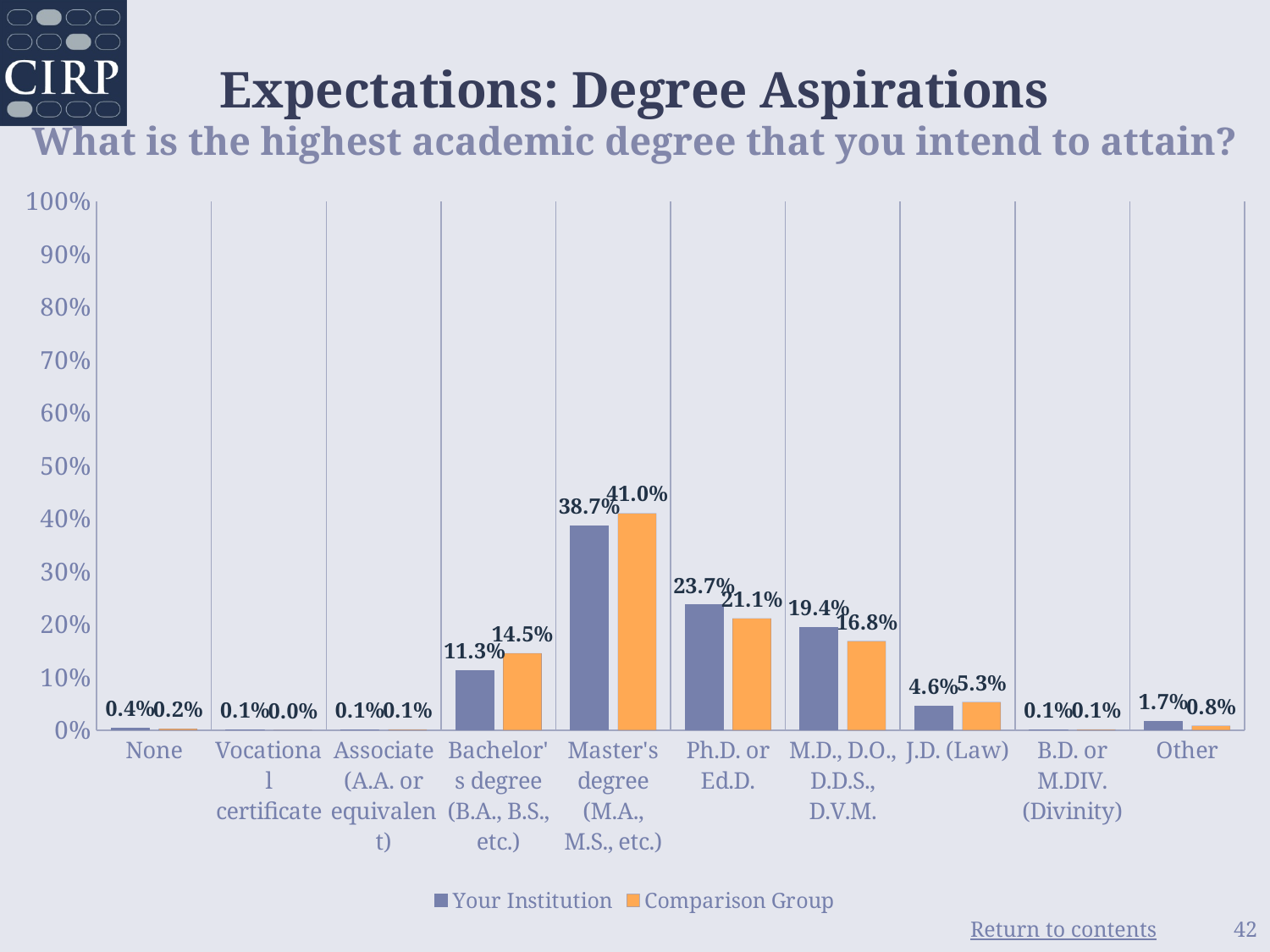
What is the value for Your Institution for Master's degree (M.A., M.S., etc.)? 38.7% What is the difference between Comparison Group and Your Institution for Bachelor's degree (B.A., B.S., etc.)? 3.2% Is the value for Your Institution for Ph.D. or Ed.D. greater or less than 20%? greater What is the value for Comparison Group for Other? 0.8% What kind of chart is shown on the slide? bar chart What is the value for Comparison Group for Ph.D. or Ed.D.? 21.1% Which is larger for M.D., D.O., D.D.S., D.V.M.: Your Institution or Comparison Group? Your Institution How many categories are shown on the x axis? 10 How many series does the legend list? 2 What question is the chart answering, according to the subtitle? What is the highest academic degree that you intend to attain? What is the value for Your Institution for J.D. (Law)? 4.6% Which category has the highest value for Comparison Group? Master's degree (M.A., M.S., etc.)